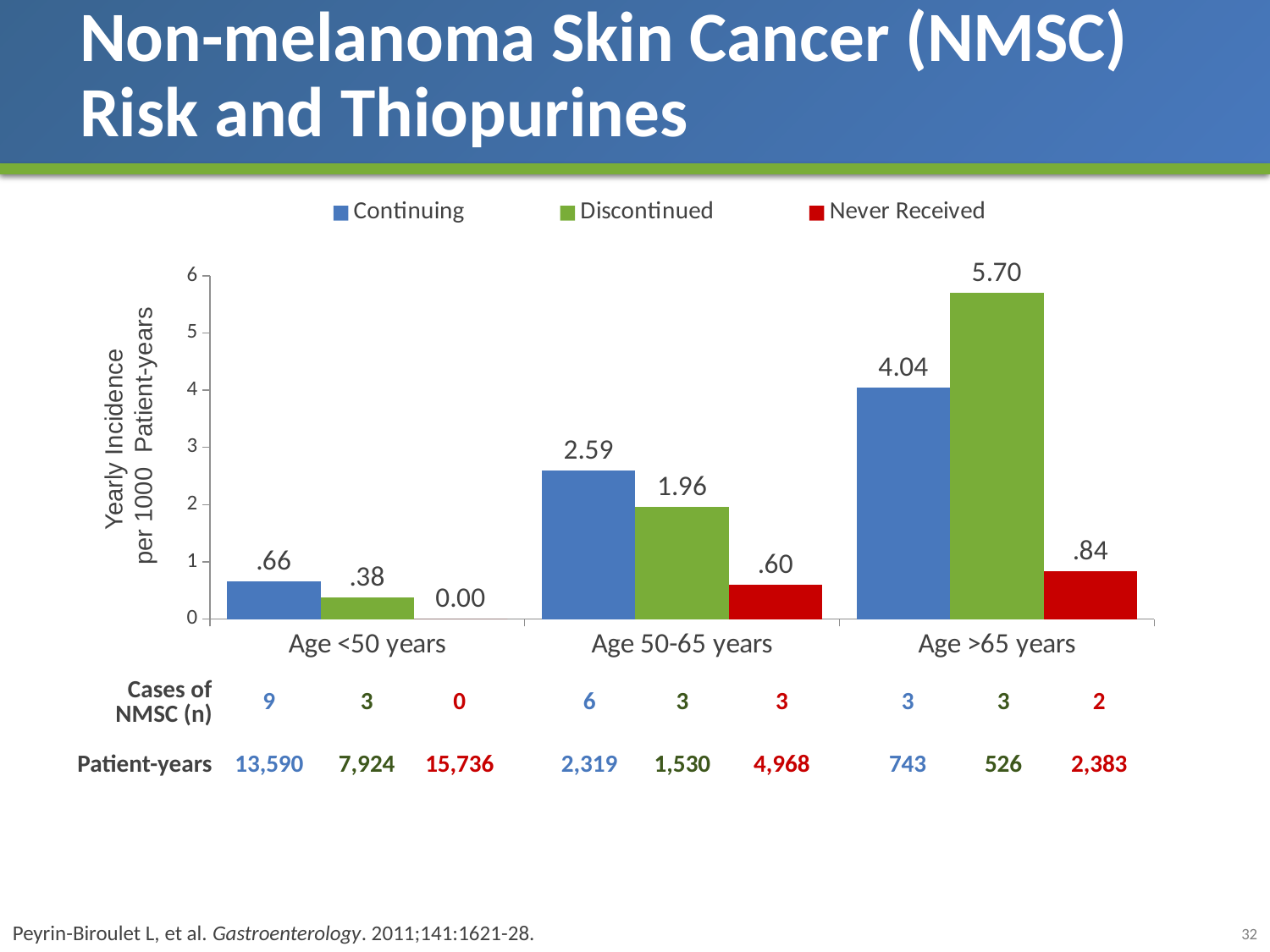
What is the yearly incidence per 1000 patient-years for the Never Received group in the Age <50 years category? 0.00 What is the difference between the Discontinued and Continuing yearly incidence values in the Age >65 years category? 1.66 What kind of chart is shown on the slide? Bar chart How many series does the legend list? 3 What is the yearly incidence per 1000 patient-years for the Continuing group in the Age 50-65 years category? 2.59 In the Age 50-65 years category, which is larger: the Continuing value or the Discontinued value? Continuing Which age category has the highest yearly incidence for the Discontinued group? Age >65 years How does the yearly incidence for the Continuing group change as age category increases from left to right? It rises How many age categories are shown on the x axis? 3 Which series has the lowest yearly incidence in the Age >65 years category? Never Received What is the yearly incidence per 1000 patient-years for the Discontinued group in the Age >65 years category? 5.70 Is the value for the Continuing group in the Age >65 years category greater or less than 3? greater